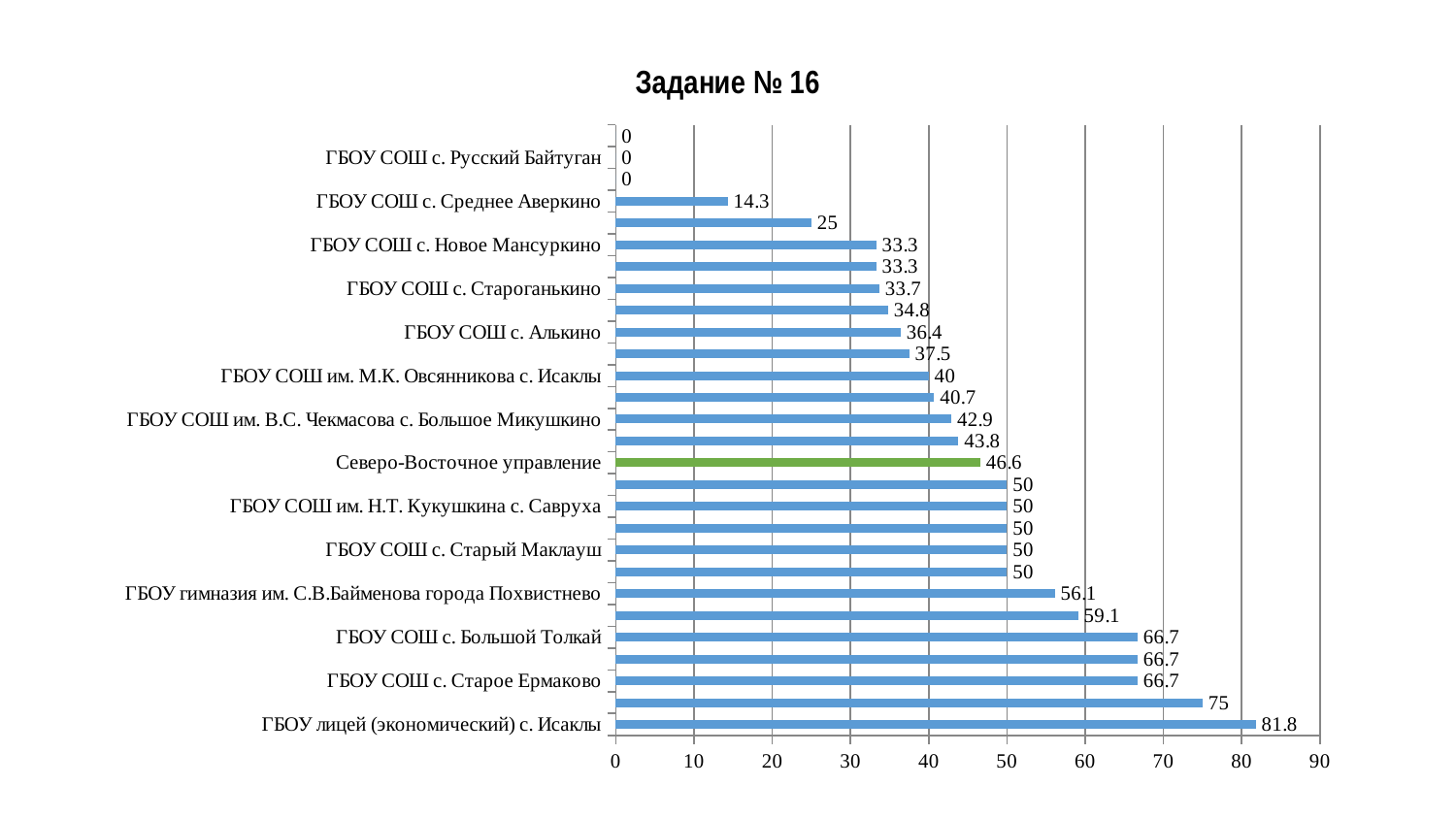
What is the value for ГБОУ гимназия им. С.В.Байменова города Похвистнево? 56.1 What is the value for Северо-Восточное управление? 46.6 What is the value for ГБОУ СОШ с. Среднее Аверкино? 14.3 Which category is shown with a green bar instead of a blue one? Северо-Восточное управление What is the value for ГБОУ лицей (экономический) с. Исаклы? 81.8 Which labeled category has the lowest value? ГБОУ СОШ с. Русский Байтуган What is the difference between the values for ГБОУ лицей (экономический) с. Исаклы and Северо-Восточное управление? 35.2 Is the value for ГБОУ СОШ с. Большой Толкай greater or less than 60? greater Which is larger, the value for ГБОУ гимназия им. С.В.Байменова города Похвистнево or for ГБОУ СОШ им. В.С. Чекмасова с. Большое Микушкино? ГБОУ гимназия им. С.В.Байменова города Похвистнево What is the title of the chart? Задание № 16 Which labeled category has the highest value? ГБОУ лицей (экономический) с. Исаклы What type of chart is shown on the slide? bar chart